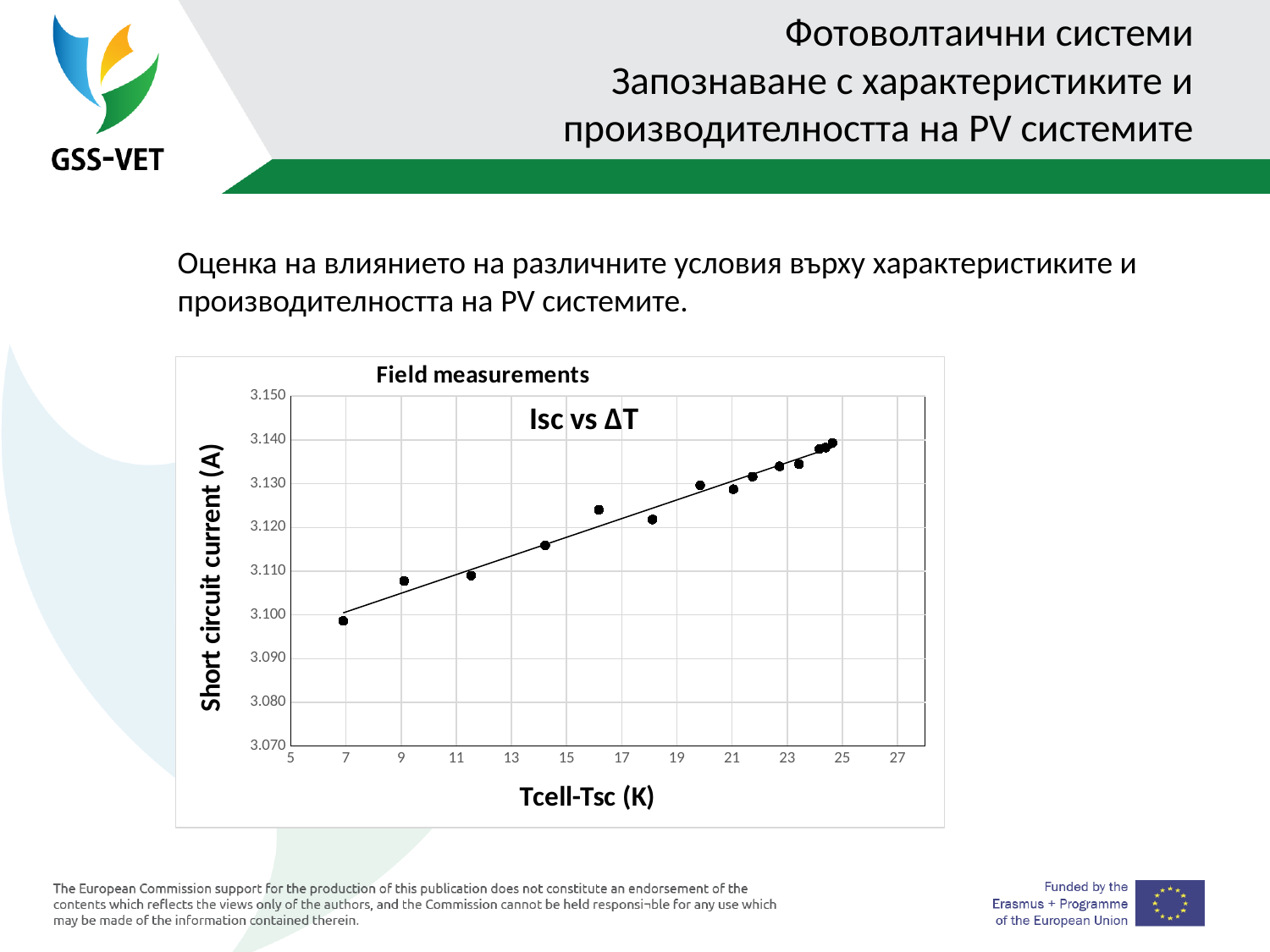
Is the short circuit current for the point near Tcell-Tsc of 20 K greater or less than 3.120? greater Which has the higher short circuit current: the point near Tcell-Tsc of 7 K or the point near Tcell-Tsc of 24 K? the point near 24 K Is the short circuit current for the rightmost point (near Tcell-Tsc of 24.5 K) greater or less than 3.130? greater Is the short circuit current for the point near Tcell-Tsc of 16 K greater or less than 3.120? greater Do the short circuit current values rise or fall as Tcell-Tsc increases along the x axis? rise What is the label of the y axis of the chart? Short circuit current (A) What kind of chart is shown on the slide? scatter chart